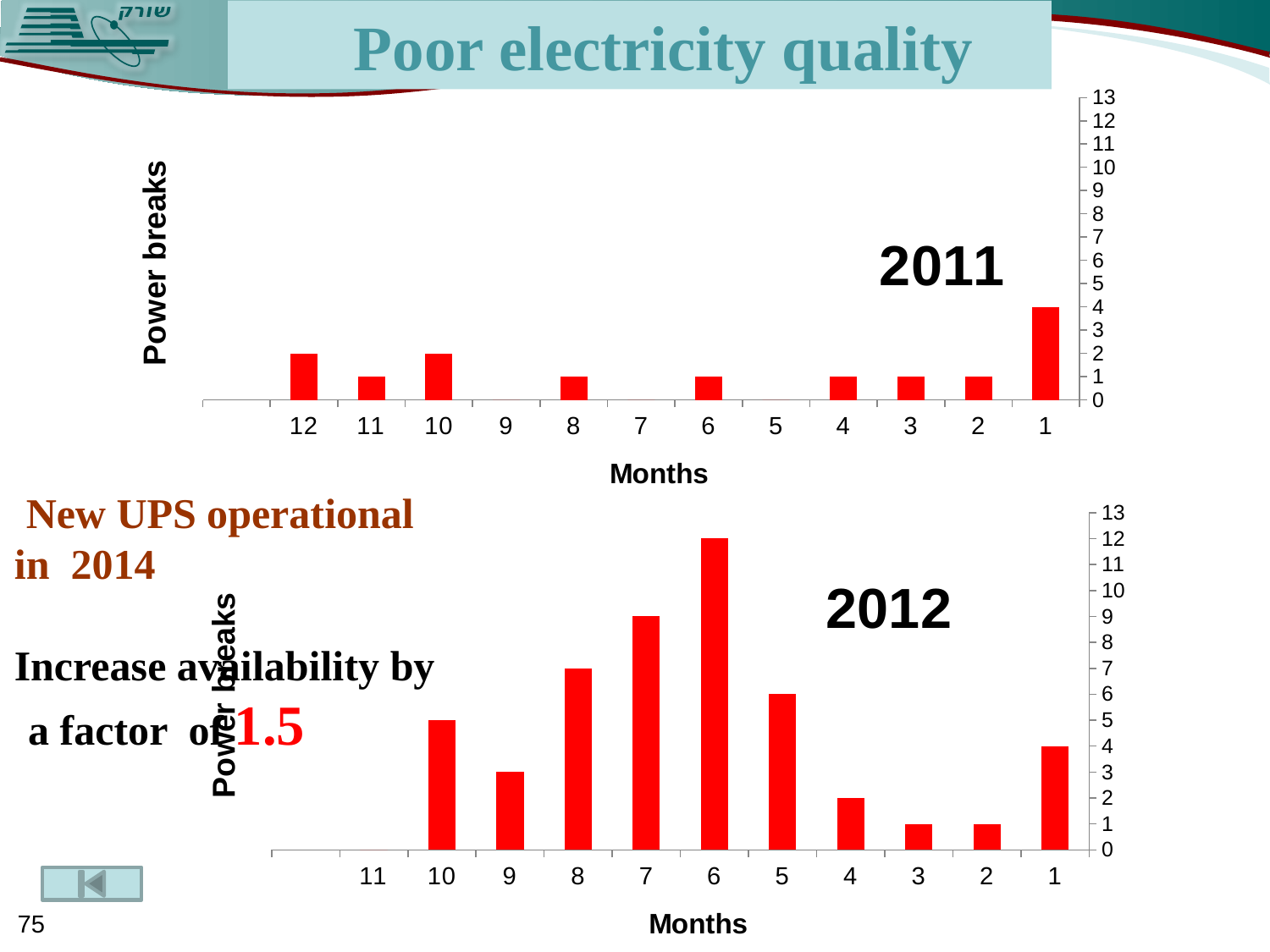
In the 2012 chart, how many power breaks are shown for month 6? 12 In the 2012 chart, is the value for month 7 greater or less than 8? greater In the 2011 chart, which month has the highest number of power breaks? 1 In the 2011 chart, how many power breaks are shown for month 1? 4 In the 2012 chart, which month has more power breaks, month 8 or month 9? 8 What type of chart is the 2012 chart? bar chart How many months are shown on the x axis of the 2011 chart? 12 In the 2012 chart, what is the difference in power breaks between month 6 and month 5? 6 In the 2011 chart, how many power breaks are shown for month 12? 2 In the 2012 chart, how many power breaks are shown for month 7? 9 In the 2012 chart, how many power breaks are shown for month 10? 5 In the 2012 chart, which month has the highest number of power breaks? 6